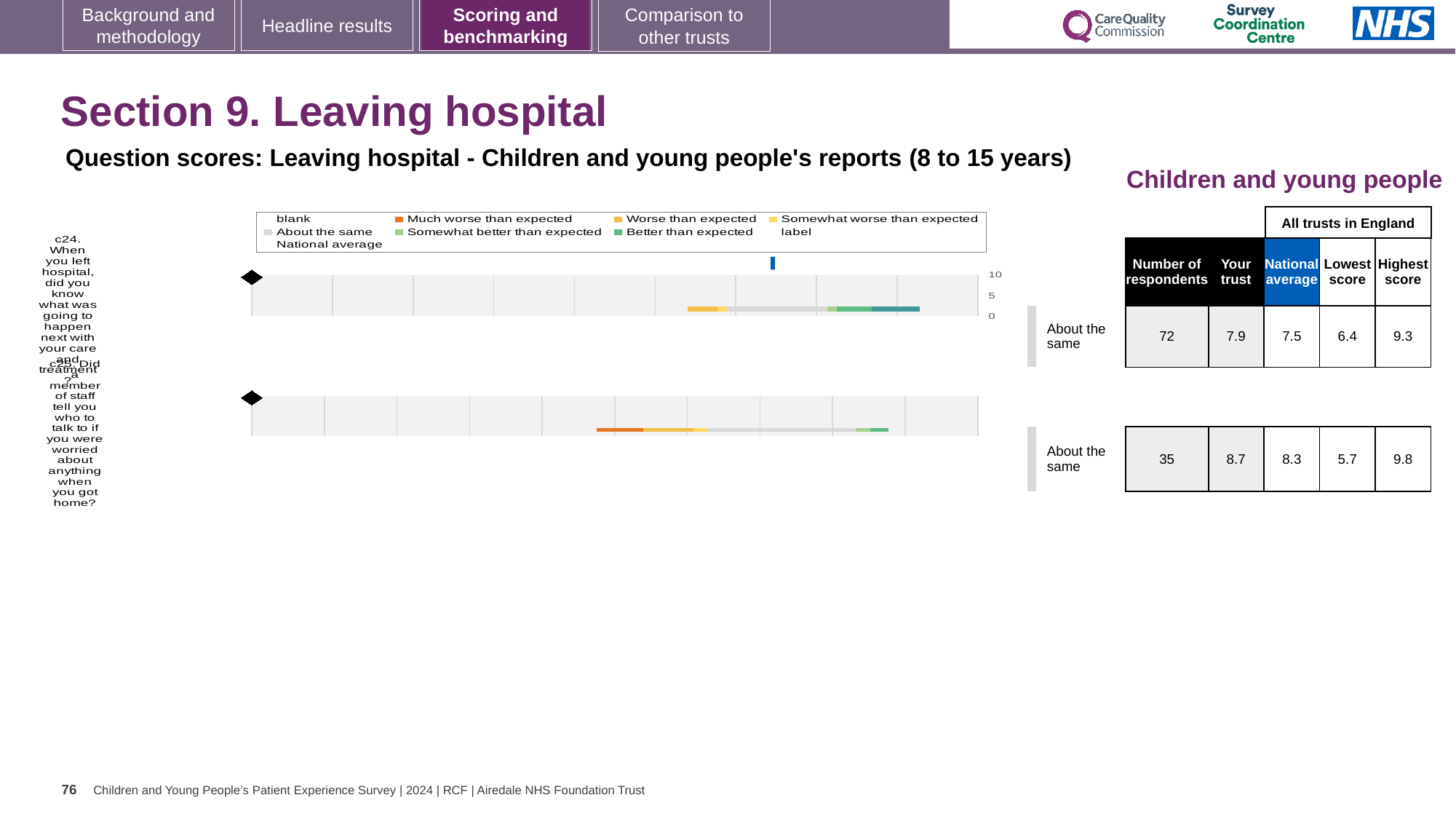
What kind of chart is used to show the question scores for Leaving hospital? bar chart What is the highest score among all trusts in England for question c24? 9.3 How many questions are plotted in the Leaving hospital chart? 2 Which question has the higher 'Your trust' score, c24 or c25? c25 What is the national average score for question c25 (Did a member of staff tell you who to talk to if you were worried about anything when you got home?)? 8.3 What is the difference between the highest score and the lowest score for question c25? 4.1 What is the 'Your trust' score for question c24 (When you left hospital, did you know what was going to happen next with your care and treatment?)? 7.9 What benchmark category is question c25 placed in? About the same In the chart legend, which category is shown in orange? Much worse than expected For question c24, which is higher: the 'Your trust' score or the national average? Your trust How many respondents answered question c24? 72